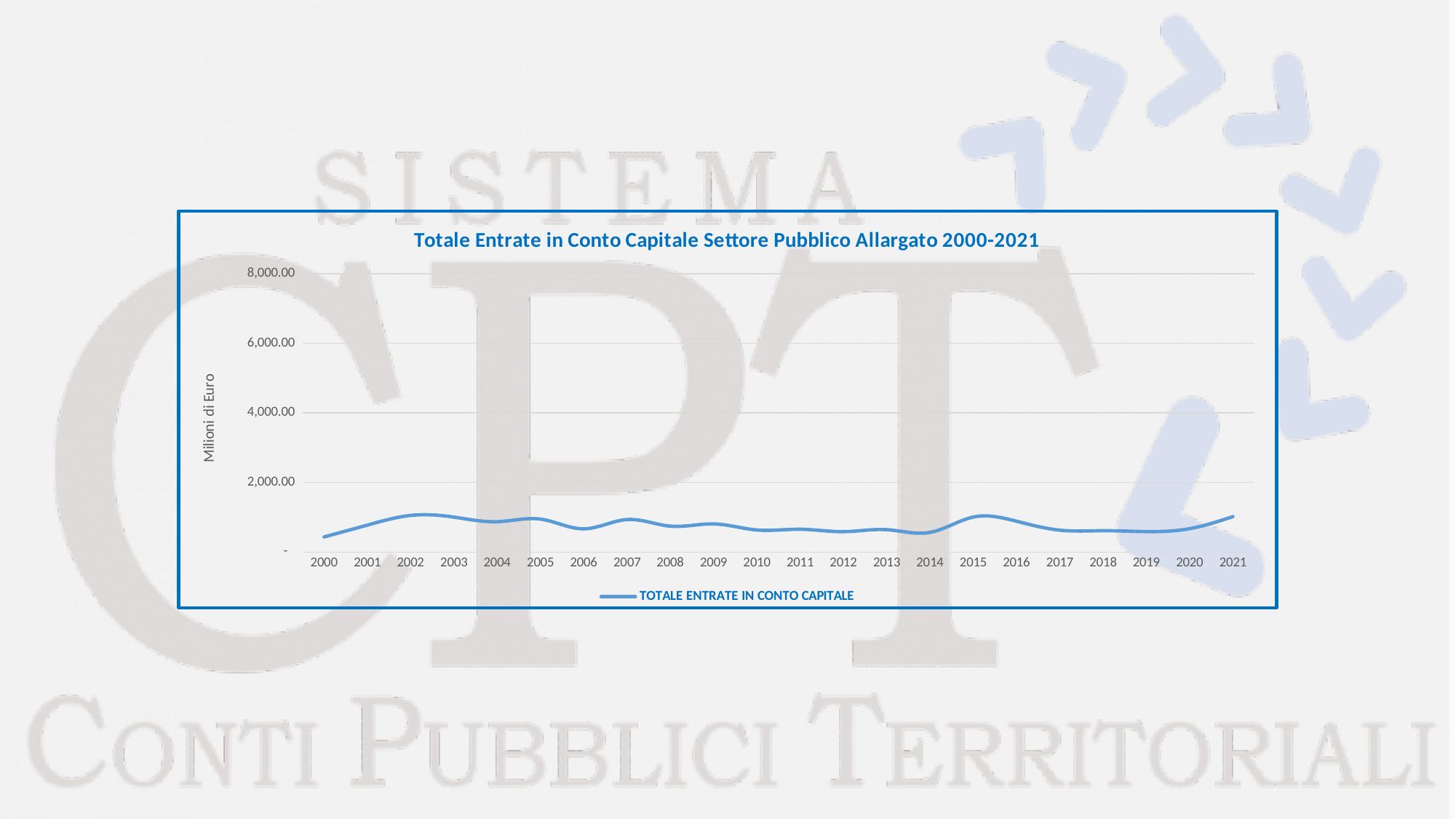
Is the value for 2002 greater or less than 2,000.00? less What is the title of the chart? Totale Entrate in Conto Capitale Settore Pubblico Allargato 2000-2021 What kind of chart is shown on the slide? line chart What is the label on the vertical axis of the chart? Milioni di Euro Which is larger, the value for 2015 or the value for 2018? 2015 Do the values rise or fall from 2000 to 2002? rise Which year has the lowest value? 2000 Is the value for 2015 greater or less than 4,000.00? less How many series does the legend list? 1 Which is larger, the value for 2000 or the value for 2002? 2002 Is the value for 2021 greater or less than 2,000.00? less How many years are plotted along the x axis? 22